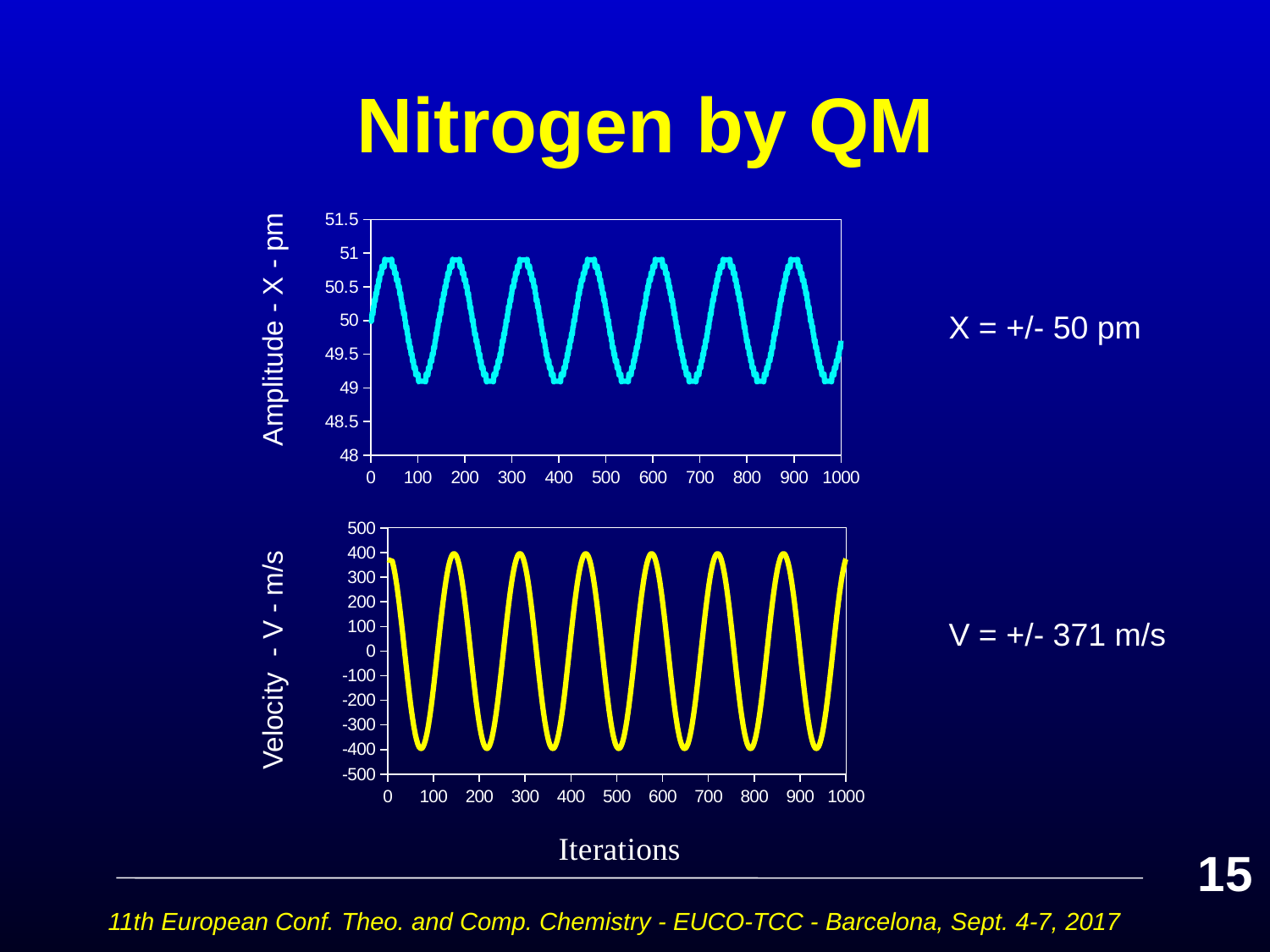
In the top chart, what is the amplitude value at iteration 0? 50 In the top chart, are the peak amplitude values greater or less than 50.5? greater In the top chart, are the trough amplitude values greater or less than 49.5? less In the top chart, how do the amplitude values behave as the iterations increase? they oscillate, rising and falling repeatedly In the bottom chart, are the peak velocity values greater or less than 300? greater What is the y-axis label of the top chart? Amplitude - X - pm What is the x-axis label shown beneath the bottom chart? Iterations How many peaks does the amplitude line reach in the top chart? 7 What kind of chart is the top chart (Amplitude - X - pm)? line chart How many charts are shown on the slide? 2 What kind of chart is the bottom chart (Velocity - V - m/s)? line chart